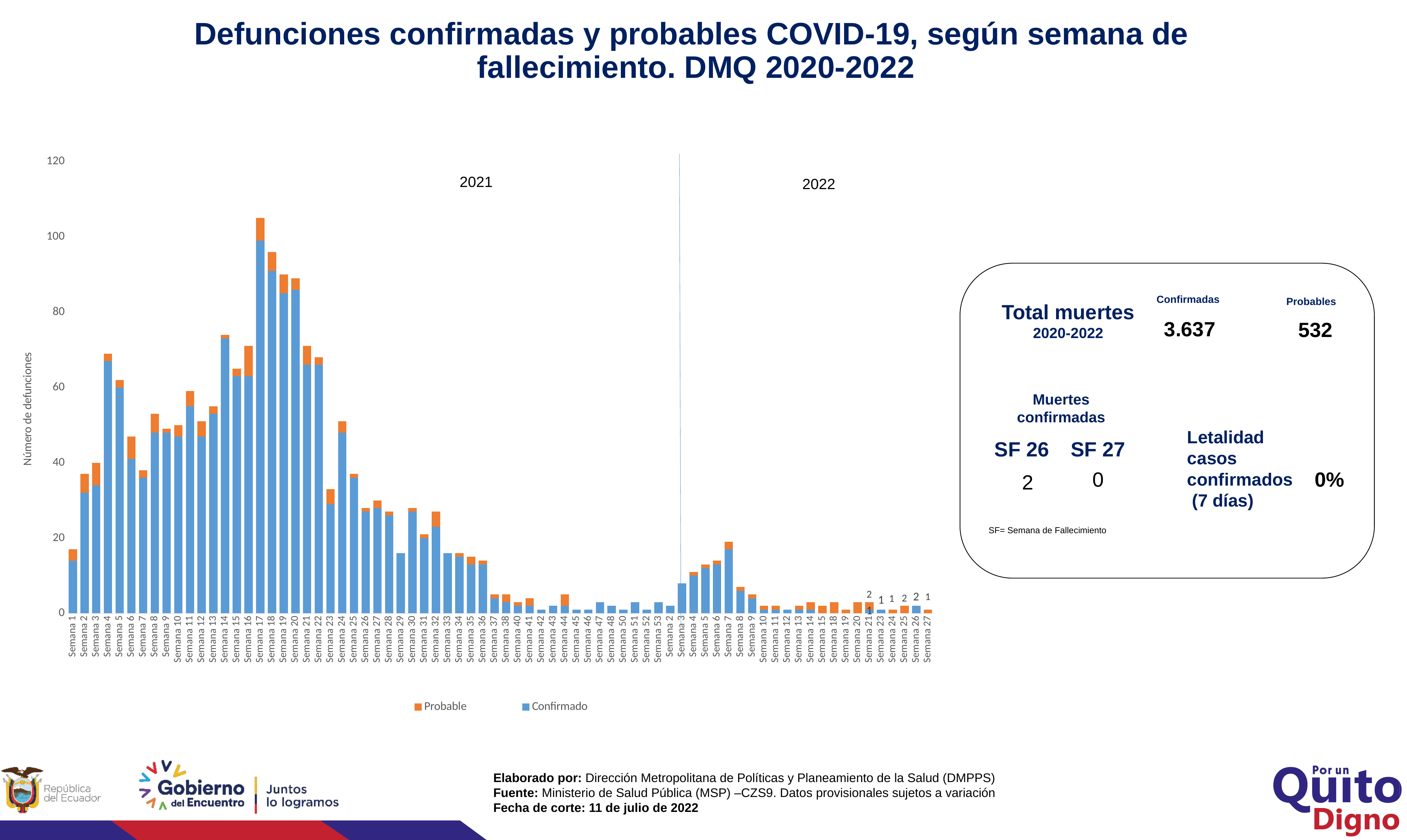
Which bar is taller, Semana 17 or Semana 18 in 2021? Semana 17 Is the total value for Semana 14 in 2021 greater or less than 60? greater What kind of chart is shown on the slide? bar chart What are the two series named in the chart legend? Probable and Confirmado What is the data label shown for Semana 25 in 2022? 2 Which week has the highest total bar in the chart? Semana 17 (2021) Do the bar values generally rise or fall from Semana 17 to Semana 53 in 2021? fall Is the total value for Semana 17 in 2021 greater or less than 100? greater Is the total value for Semana 1 in 2021 greater or less than 20? less Which bar is taller, Semana 4 or Semana 1 in 2021? Semana 4 What is the label on the vertical axis of the chart? Número de defunciones How many series does the chart legend list? 2